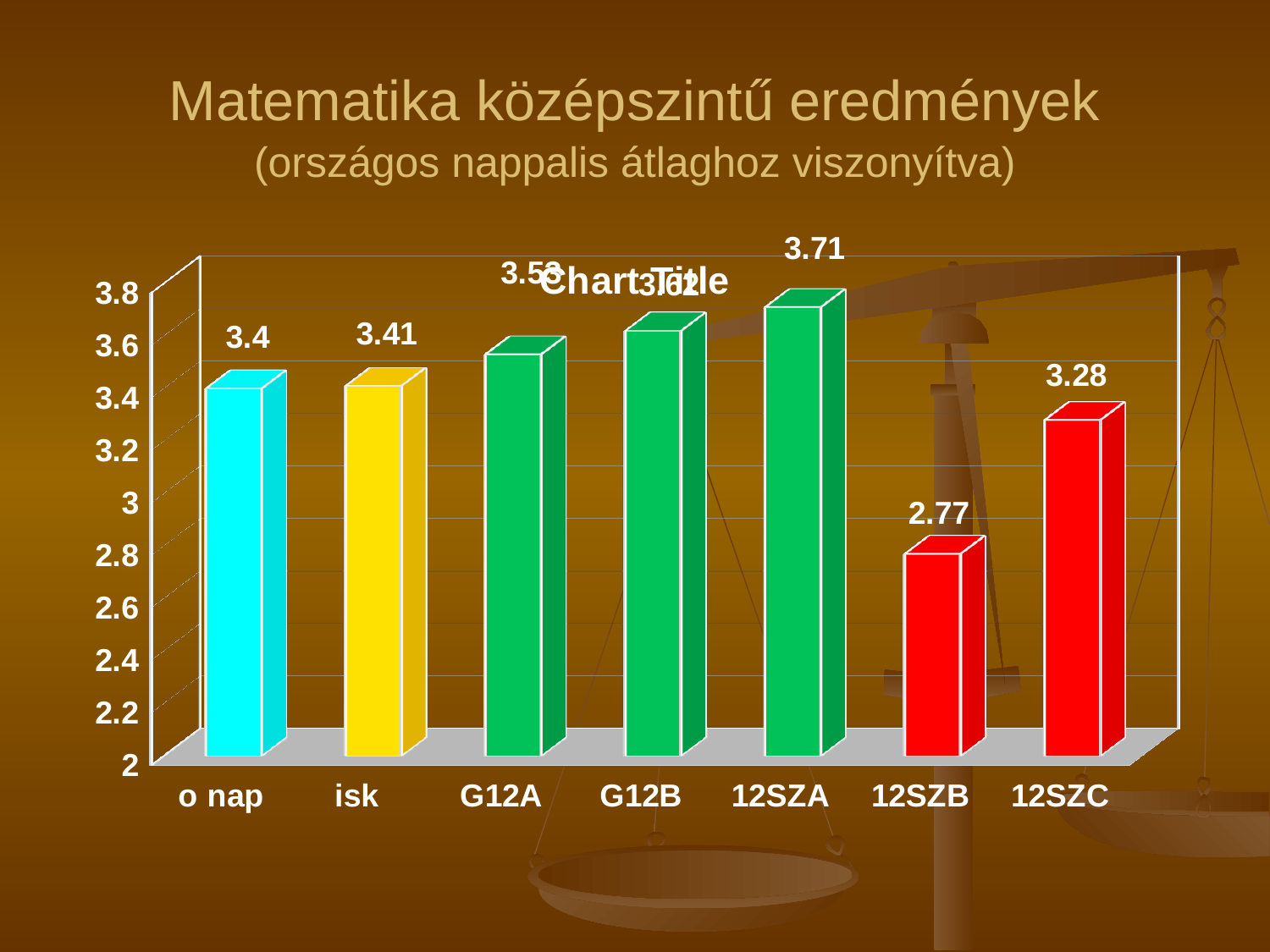
Is the value for G12B greater or less than 3.4? greater What is the value for o nap? 3.4 What is the value for 12SZB? 2.77 What is the value for 12SZA? 3.71 Which category has the lowest value? 12SZB What is the difference between the values for 12SZA and 12SZB? 0.94 Which is larger, the value for 12SZC or the value for o nap? o nap Which category has the highest value? 12SZA What is the value for isk? 3.41 What is the value for 12SZC? 3.28 What kind of chart is shown on the slide? bar chart How many categories are shown on the x axis? 7